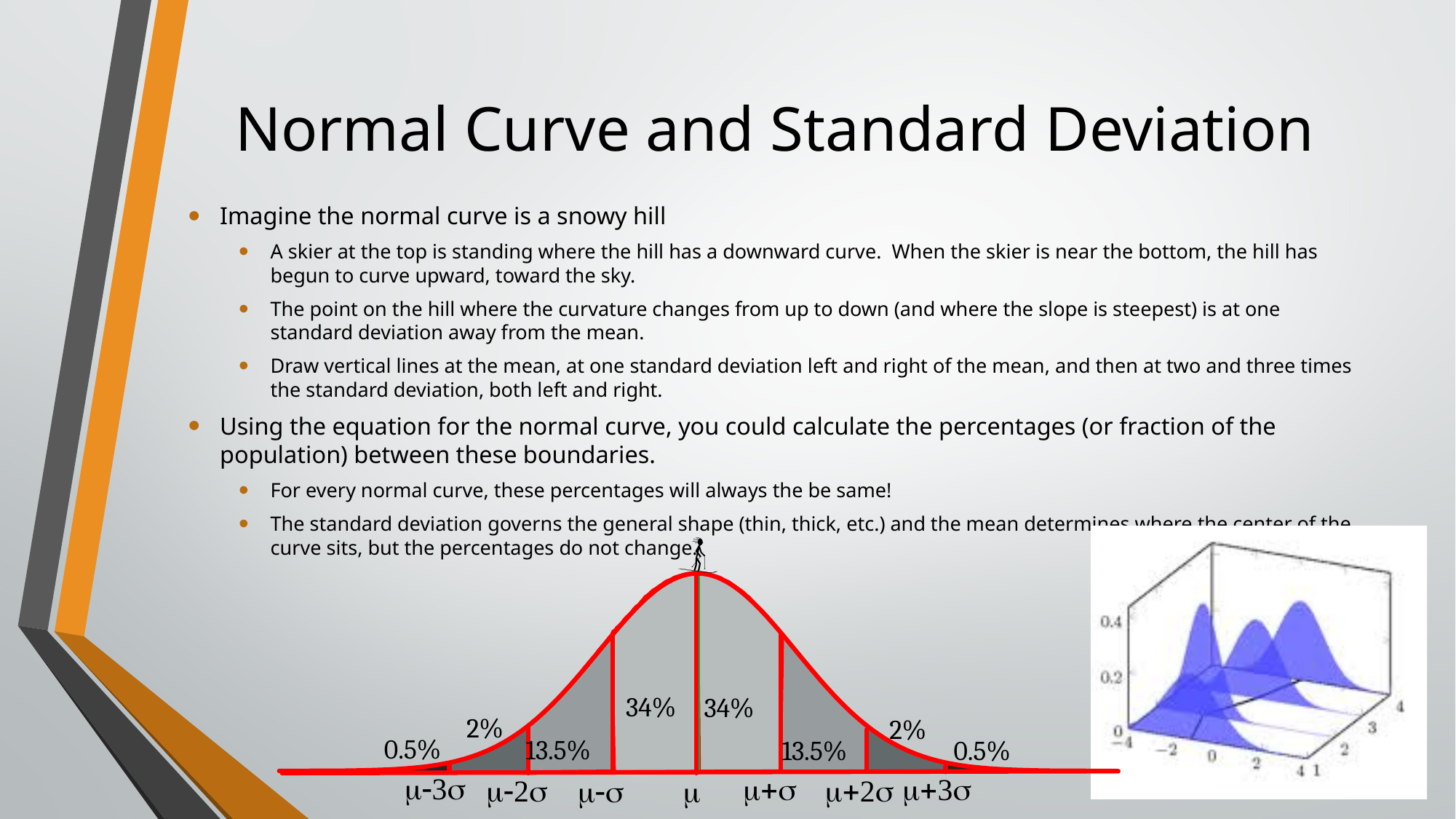
In the normal curve diagram, what percentage is labeled for the region between μ-2σ and μ-σ? 13.5% In the normal curve diagram, what is the combined percentage of the two regions between μ-σ and μ+σ? 68% In the normal curve diagram, which labeled percentage is the smallest? 0.5% In the normal curve diagram, what percentage is labeled for the region beyond μ+3σ? 0.5% In the normal curve diagram, what is the difference between the 34% region and the 13.5% region? 20.5% In the normal curve diagram, what is the combined percentage of the four regions between μ-2σ and μ+2σ? 95% How many percentage labels are shown on the normal curve diagram? 8 In the normal curve diagram, what percentage is labeled for the region between μ+2σ and μ+3σ? 2% In the normal curve diagram, what percentage is labeled for the region between μ and μ+σ? 34% In the normal curve diagram, is the region between μ-σ and μ larger or smaller than the region between μ-2σ and μ-σ? larger How many vertical boundary lines (from μ-3σ to μ+3σ) are drawn on the normal curve diagram? 7 In the normal curve diagram, which labeled percentage is the largest? 34%